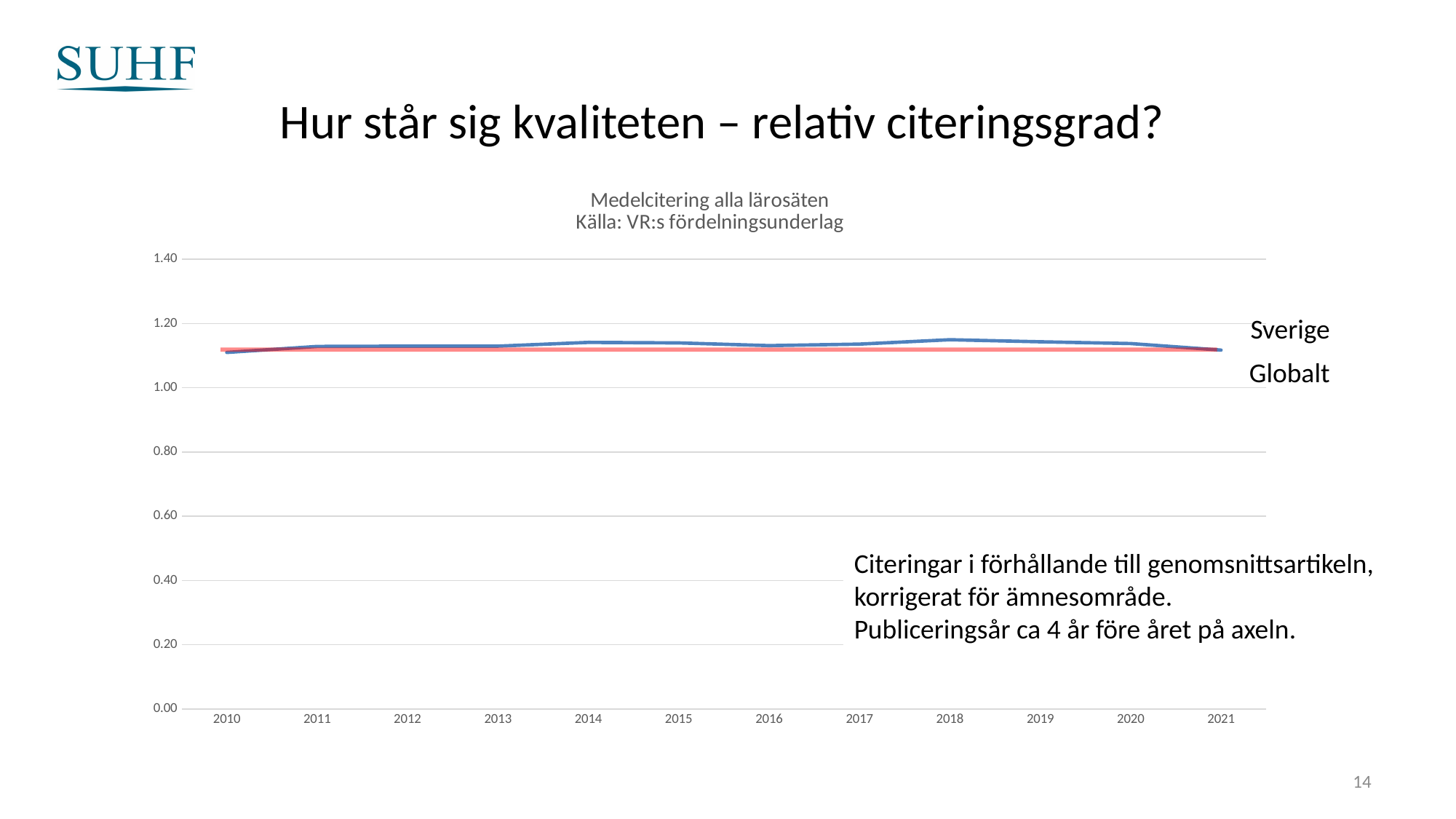
How many years are shown on the x axis of the chart? 12 In 2018, which series has the higher value, Sverige or Globalt? Sverige What kind of chart is shown on the slide? line chart What is the first year shown on the x axis? 2010 How many series does the chart show? 2 What is the title of the chart? Medelcitering alla lärosäten Källa: VR:s fördelningsunderlag Is the value for Globalt in 2015 greater or less than 1.00? greater Is the value for Sverige in 2014 greater or less than 1.20? less Is the value for Globalt in 2012 greater or less than 1.20? less Does the Sverige line rise or fall from 2018 to 2021? fall What are the names of the two series in the chart? Sverige and Globalt